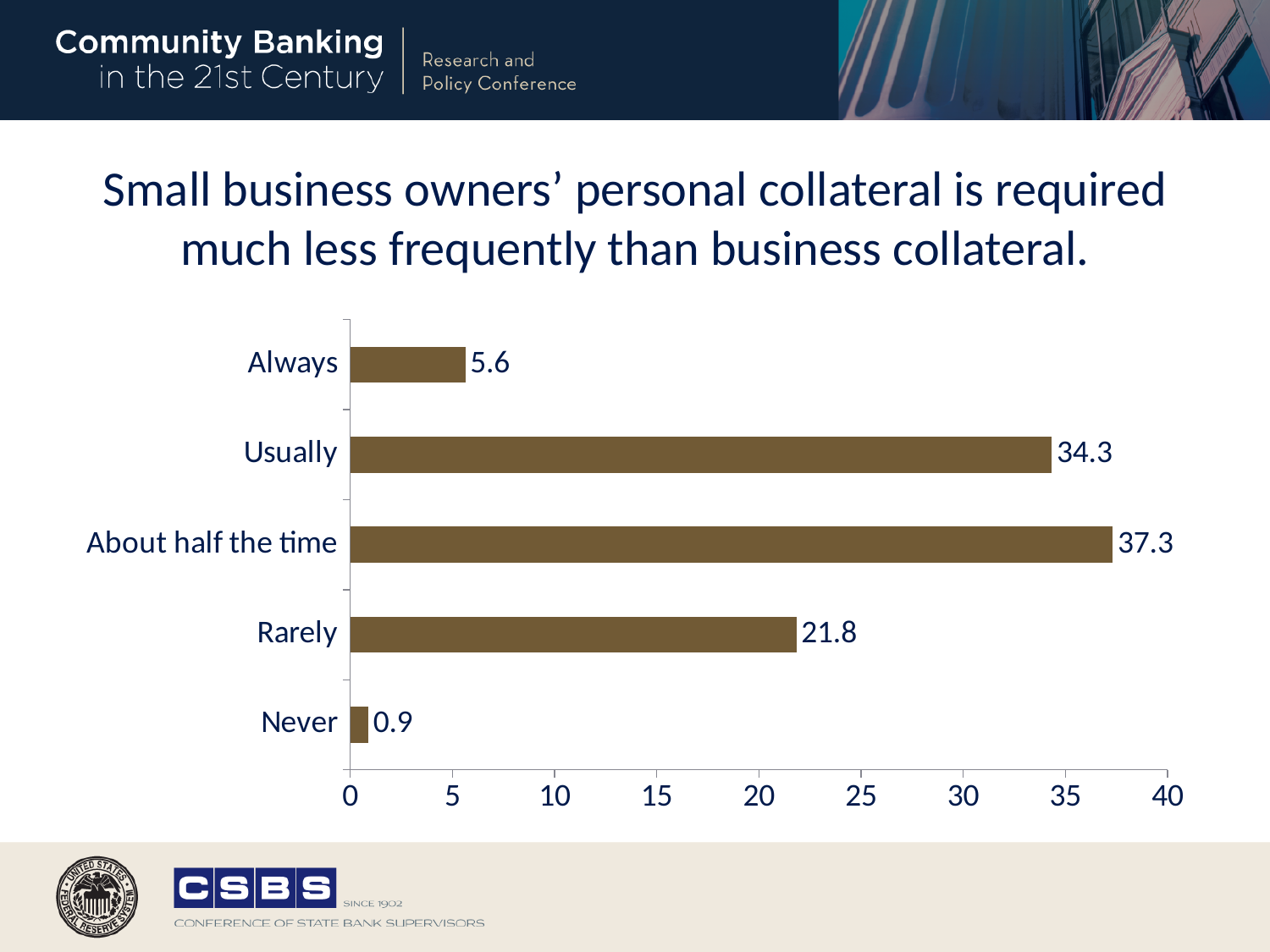
What is the maximum value shown on the horizontal axis? 40 Which is larger, the value for "Always" or the value for "Rarely"? Rarely What is the value for "Never"? 0.9 What is the value for "Rarely"? 21.8 What is the difference between the values for "Rarely" and "Always"? 16.2 How many categories are shown in the chart? 5 What kind of chart is shown on the slide? Bar chart Is the value for "Usually" greater or less than 30? greater What is the difference between the values for "About half the time" and "Usually"? 3.0 Which category has the lowest value? Never What is the value for "Usually"? 34.3 Which category has the highest value? About half the time